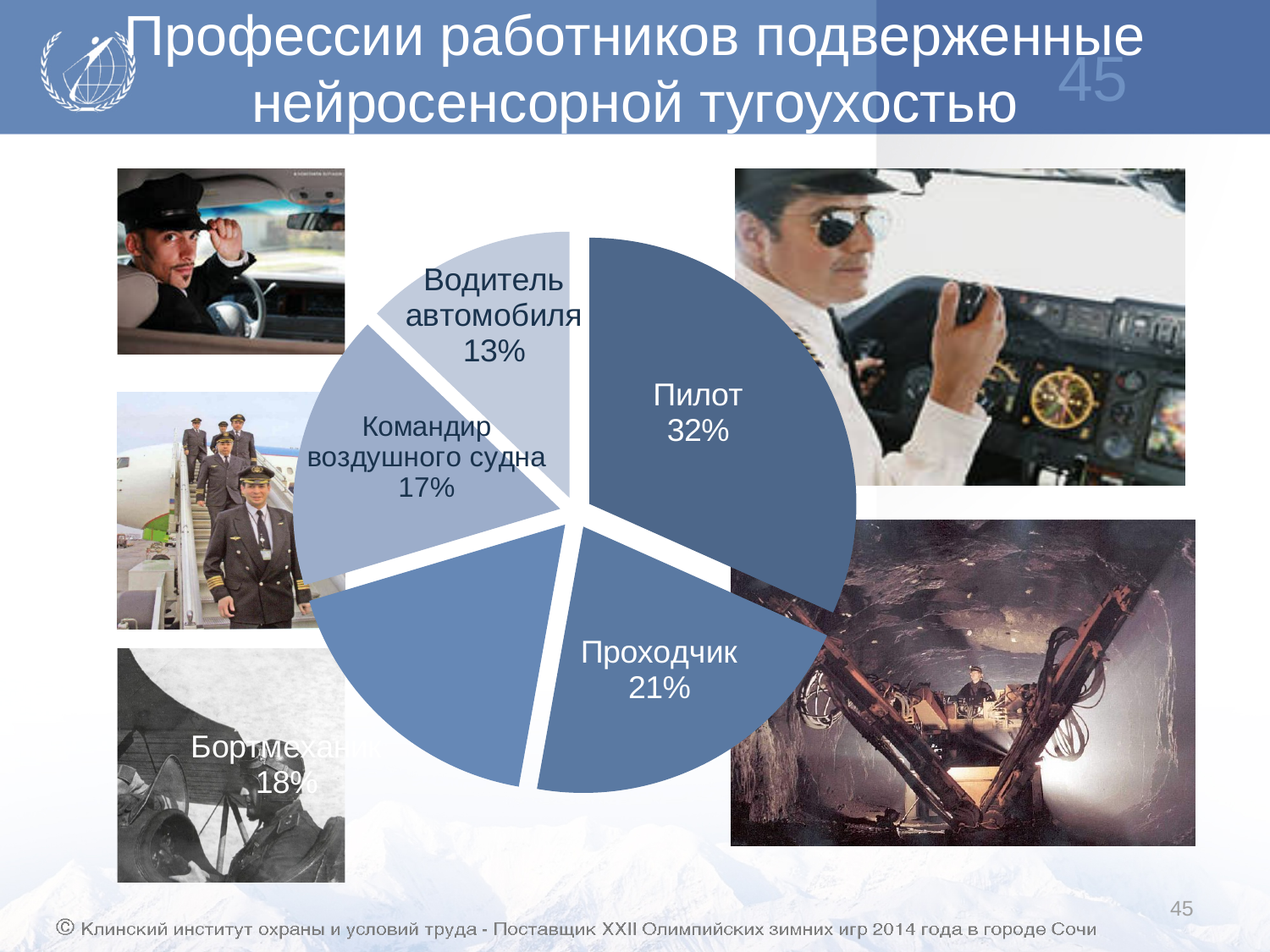
What percentage is shown for Проходчик? 21% What percentage is shown for Бортмеханик? 18% What kind of chart is shown on the slide? pie chart How many slices does the pie chart have? 5 What is the title of the slide containing the pie chart? Профессии работников подверженные нейросенсорной тугоухостью What share of the pie chart is labelled Пилот? 32% What percentage is shown for Командир воздушного судна? 17% Which profession has the largest slice of the pie chart? Пилот Which is larger, the share for Бортмеханик or the share for Командир воздушного судна? Бортмеханик What is the difference in percentage points between Пилот and Проходчик? 11 What percentage is shown for Водитель автомобиля? 13% Which profession has the smallest slice of the pie chart? Водитель автомобиля